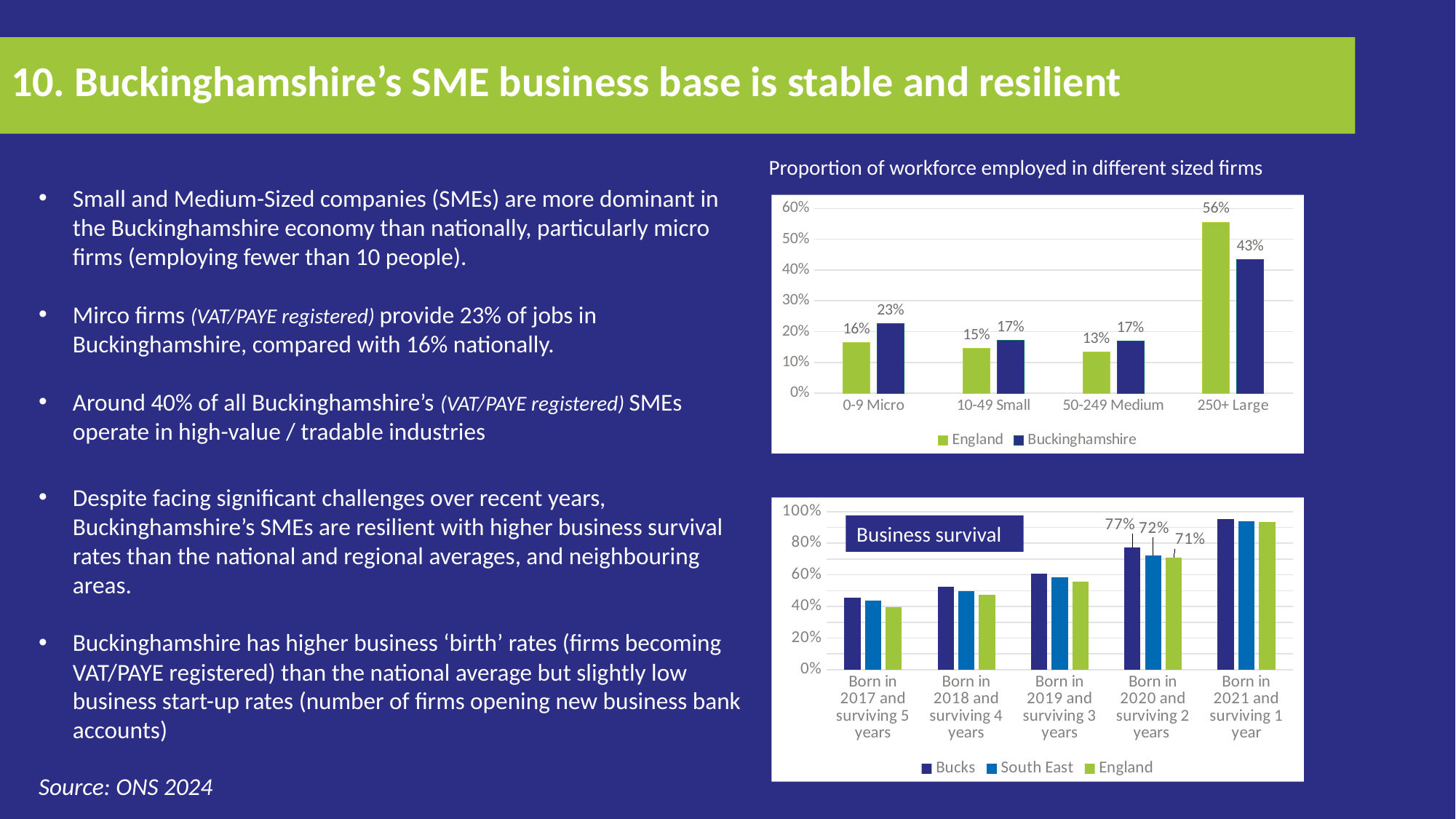
In the 'Proportion of workforce employed in different sized firms' chart, what is the difference between the England and Buckinghamshire values for 250+ Large? 13% In the 'Proportion of workforce employed in different sized firms' chart, which is larger for 50-249 Medium: England or Buckinghamshire? Buckinghamshire In the 'Business survival' chart, is the value for Bucks for firms born in 2021 and surviving 1 year greater or less than 80%? greater In the 'Proportion of workforce employed in different sized firms' chart, what is the value for Buckinghamshire in the 0-9 Micro category? 23% How many series does the legend of the 'Business survival' chart list? 3 In the 'Business survival' chart, what is the value for Bucks for firms born in 2020 and surviving 2 years? 77% In the 'Proportion of workforce employed in different sized firms' chart, which firm size category has the lowest value for England? 50-249 Medium How many firm size categories are shown in the 'Proportion of workforce employed in different sized firms' chart? 4 In the 'Proportion of workforce employed in different sized firms' chart, which firm size category has the highest value for Buckinghamshire? 250+ Large In the 'Proportion of workforce employed in different sized firms' chart, what is the value for England in the 250+ Large category? 56% What kind of chart is the 'Business survival' chart? Bar chart In the 'Business survival' chart, what is the difference between the Bucks and England values for firms born in 2020 and surviving 2 years? 6%